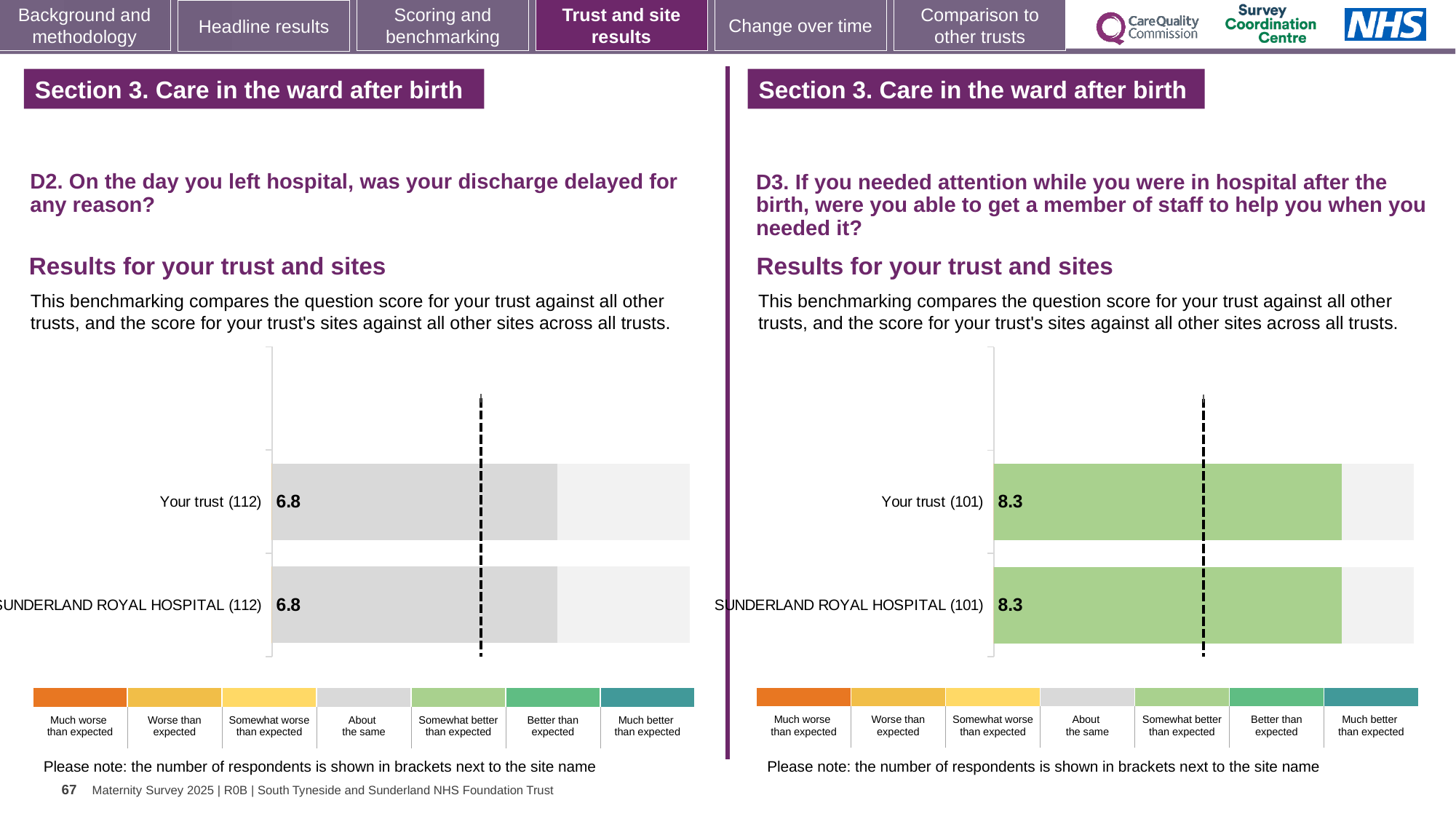
In the left chart (D2, discharge delayed), what is the score for Sunderland Royal Hospital? 6.8 In the right chart (D3, able to get a member of staff to help), what is the score for Your trust? 8.3 In the left chart (D2, discharge delayed), what is the score for Your trust? 6.8 In the left chart (D2), how many respondents are shown in brackets next to Your trust? 112 How many bars are plotted in the right chart (D3)? 2 How many bars are plotted in the left chart (D2)? 2 What kind of chart is used in the left chart (D2)? Bar chart In the left chart (D2), what is the difference between the Your trust score and the Sunderland Royal Hospital score? 0 In the right chart (D3, able to get a member of staff to help), what is the score for Sunderland Royal Hospital? 8.3 In the right chart (D3), how many respondents are shown in brackets next to Sunderland Royal Hospital? 101 In the right chart (D3), what is the difference between the Your trust score and the Sunderland Royal Hospital score? 0 Is the Your trust score in the right chart (D3) larger or smaller than the Your trust score in the left chart (D2)? Larger